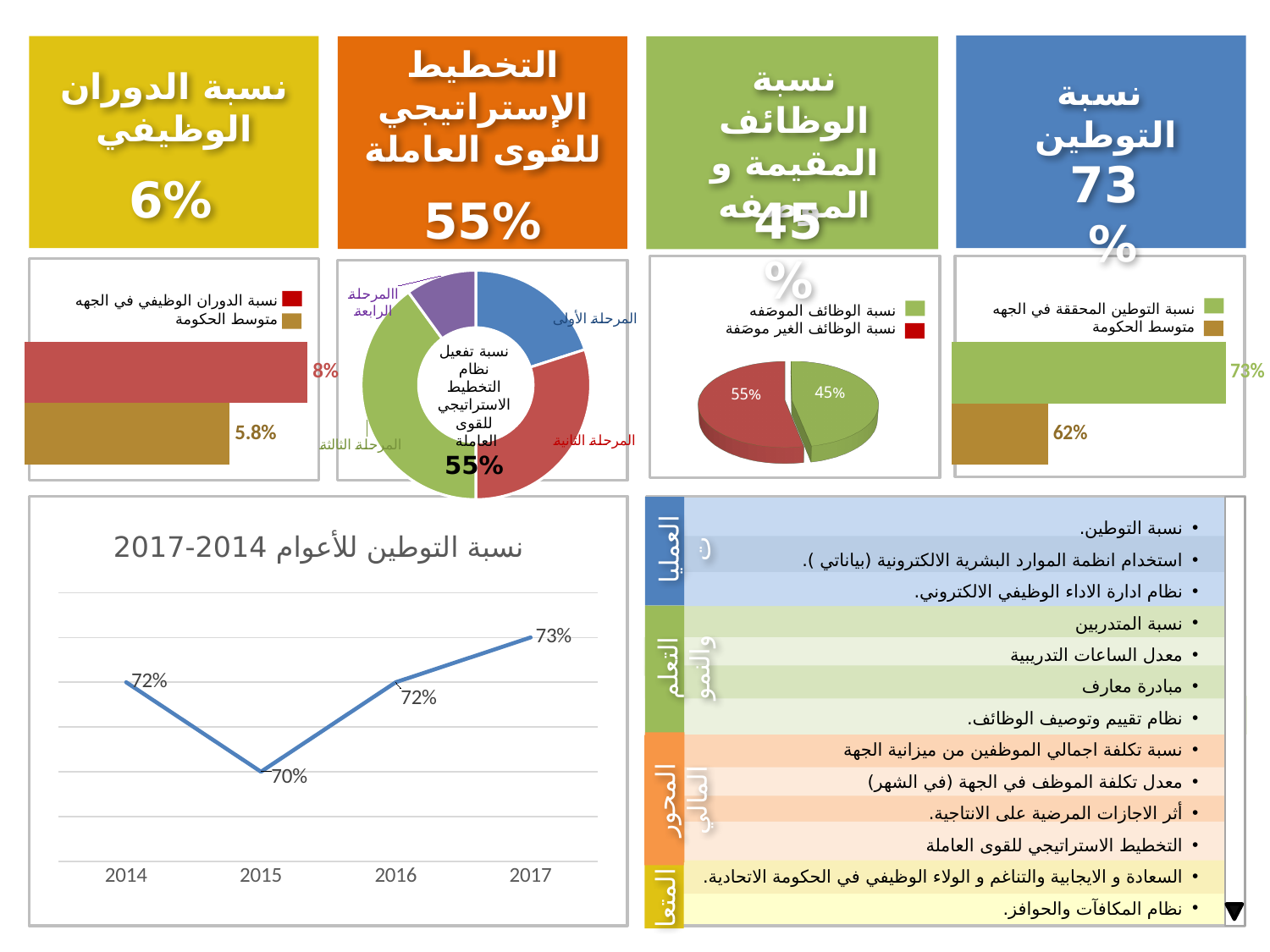
In the line chart titled 'نسبة التوطين للأعوام 2014-2017', how many years are plotted? 4 In the bar chart under the 'نسبة الدوران الوظيفي' header (top left), what is the value for 'نسبة الدوران الوظيفي في الجهه'? 8% In the pie chart under the 'نسبة الوظائف المقيمة و الموصفه' header, what share does 'نسبة الوظائف الغير موصفة' have? 55% In the bar chart under the 'نسبة التوطين' header (top right), what is the difference between 'نسبة التوطين المحققة في الجهه' and 'متوسط الحكومة'? 11% In the line chart titled 'نسبة التوطين للأعوام 2014-2017', what is the difference between the 2017 value and the 2015 value? 3% In the bar chart under the 'نسبة الدوران الوظيفي' header (top left), which is larger: 'نسبة الدوران الوظيفي في الجهه' or 'متوسط الحكومة'? نسبة الدوران الوظيفي في الجهه In the line chart titled 'نسبة التوطين للأعوام 2014-2017', which year has the lowest value? 2015 In the line chart titled 'نسبة التوطين للأعوام 2014-2017', does the value rise or fall from 2015 to 2017? rise In the line chart titled 'نسبة التوطين للأعوام 2014-2017', what is the value for 2015? 70% In the line chart titled 'نسبة التوطين للأعوام 2014-2017', which year has the highest value? 2017 In the donut chart under the 'التخطيط الإستراتيجي للقوى العاملة' header, how many segments (stages) are shown? 4 In the bar chart under the 'نسبة التوطين' header (top right), what is the value for 'متوسط الحكومة'? 62%